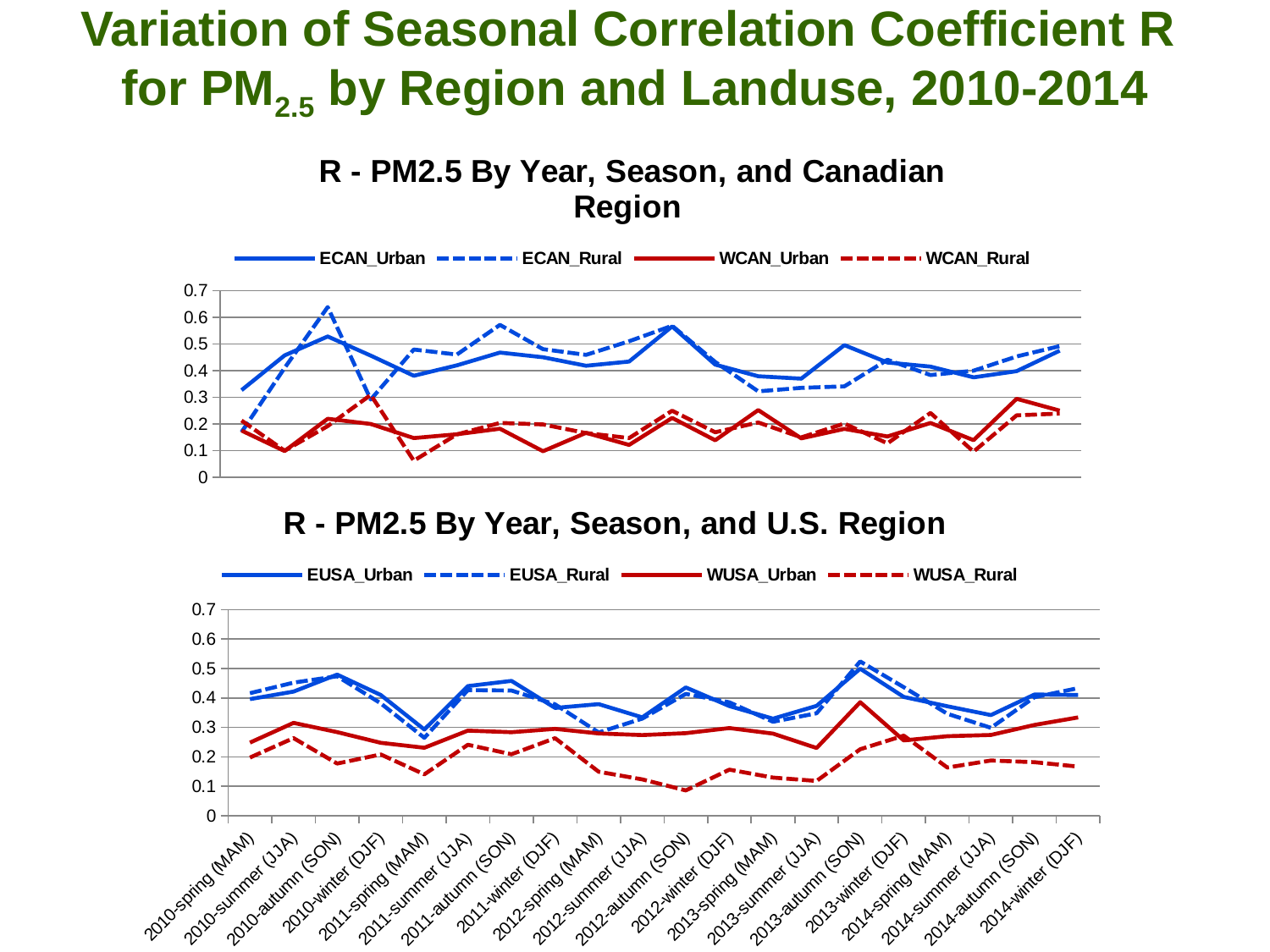
In the 'R - PM2.5 By Year, Season, and U.S. Region' chart, which series has the lowest value on the chart? WUSA_Rural In the 'R - PM2.5 By Year, Season, and Canadian Region' chart, is the ECAN_Rural value for 2010-autumn (SON) greater or less than 0.6? greater In the 'R - PM2.5 By Year, Season, and U.S. Region' chart, is the WUSA_Urban value for 2013-autumn (SON) greater or less than 0.3? greater In the 'R - PM2.5 By Year, Season, and U.S. Region' chart, at 2013-autumn (SON), which is higher: WUSA_Urban or WUSA_Rural? WUSA_Urban In the 'R - PM2.5 By Year, Season, and U.S. Region' chart, is the WUSA_Rural value for 2012-autumn (SON) greater or less than 0.1? less How many season categories are shown along the x axis of the 'R - PM2.5 By Year, Season, and U.S. Region' chart? 20 How many series does the legend of the 'R - PM2.5 By Year, Season, and U.S. Region' chart list? 4 In the 'R - PM2.5 By Year, Season, and Canadian Region' chart, what colour are the WCAN_Urban and WCAN_Rural lines? red In the 'R - PM2.5 By Year, Season, and Canadian Region' chart, which series reaches the highest value on the chart? ECAN_Rural In the 'R - PM2.5 By Year, Season, and Canadian Region' chart, at 2010-autumn (SON), which is higher: ECAN_Urban or ECAN_Rural? ECAN_Rural What kind of chart is the 'R - PM2.5 By Year, Season, and Canadian Region' chart? line chart